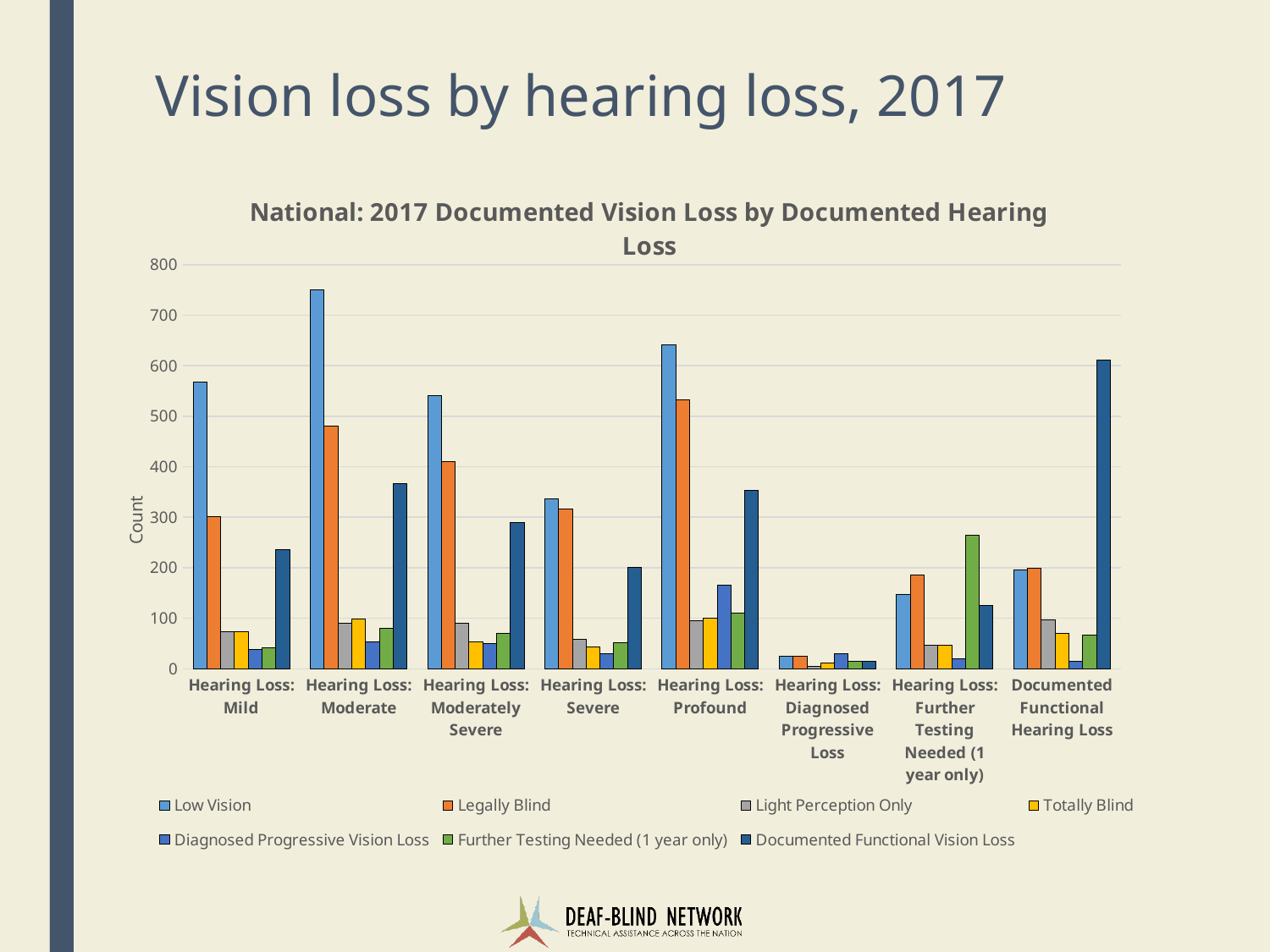
Which hearing loss category has the lowest Low Vision bar? Hearing Loss: Diagnosed Progressive Loss How many hearing loss categories are shown on the x axis? 8 Is the Legally Blind value for Hearing Loss: Profound greater or less than 500? greater What kind of chart is shown on the slide? Bar chart What is the label on the y axis? Count How many series does the legend list? 7 Is the Documented Functional Vision Loss value for Hearing Loss: Mild greater or less than 200? greater Which is larger: the Low Vision value for Hearing Loss: Profound or for Hearing Loss: Moderately Severe? Hearing Loss: Profound Which is larger: the Legally Blind value for Hearing Loss: Moderate or for Hearing Loss: Severe? Hearing Loss: Moderate Is the Documented Functional Vision Loss value for Documented Functional Hearing Loss greater or less than 500? greater Which hearing loss category has the highest Low Vision bar? Hearing Loss: Moderate